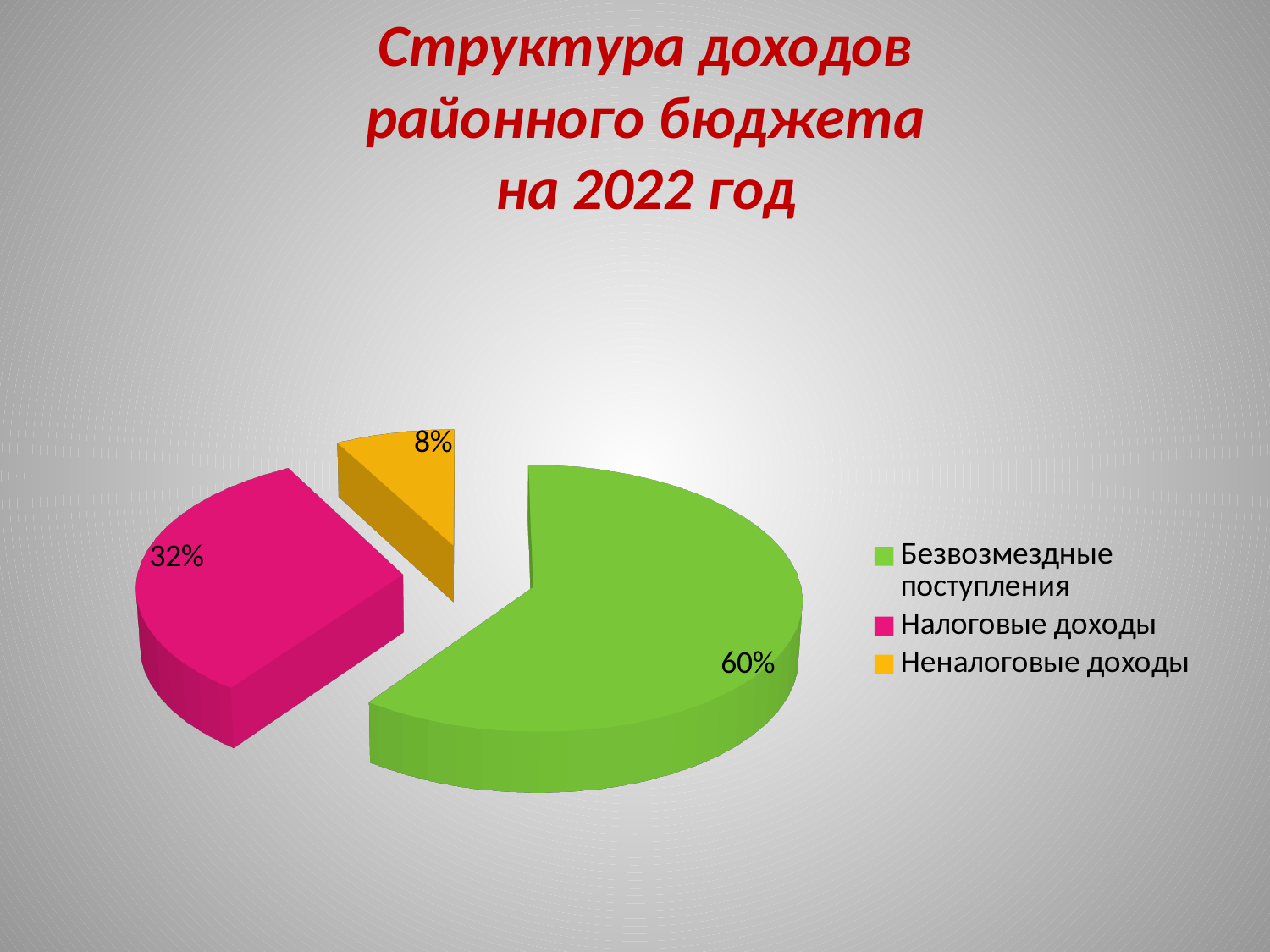
Which is larger, Налоговые доходы or Неналоговые доходы? Налоговые доходы Which category has the largest slice of the pie? Безвозмездные поступления How many categories does the pie chart show? 3 What is the title of the slide? Структура доходов районного бюджета на 2022 год What share of the pie does Неналоговые доходы have? 8% What kind of chart is shown on the slide? Pie chart What share of the pie does Налоговые доходы have? 32% What colour is the slice for Налоговые доходы? Pink What is the difference in percentage points between Налоговые доходы and Неналоговые доходы? 24 Which category has the smallest slice of the pie? Неналоговые доходы What is the difference in percentage points between Безвозмездные поступления and Налоговые доходы? 28 What share of the pie does Безвозмездные поступления have? 60%